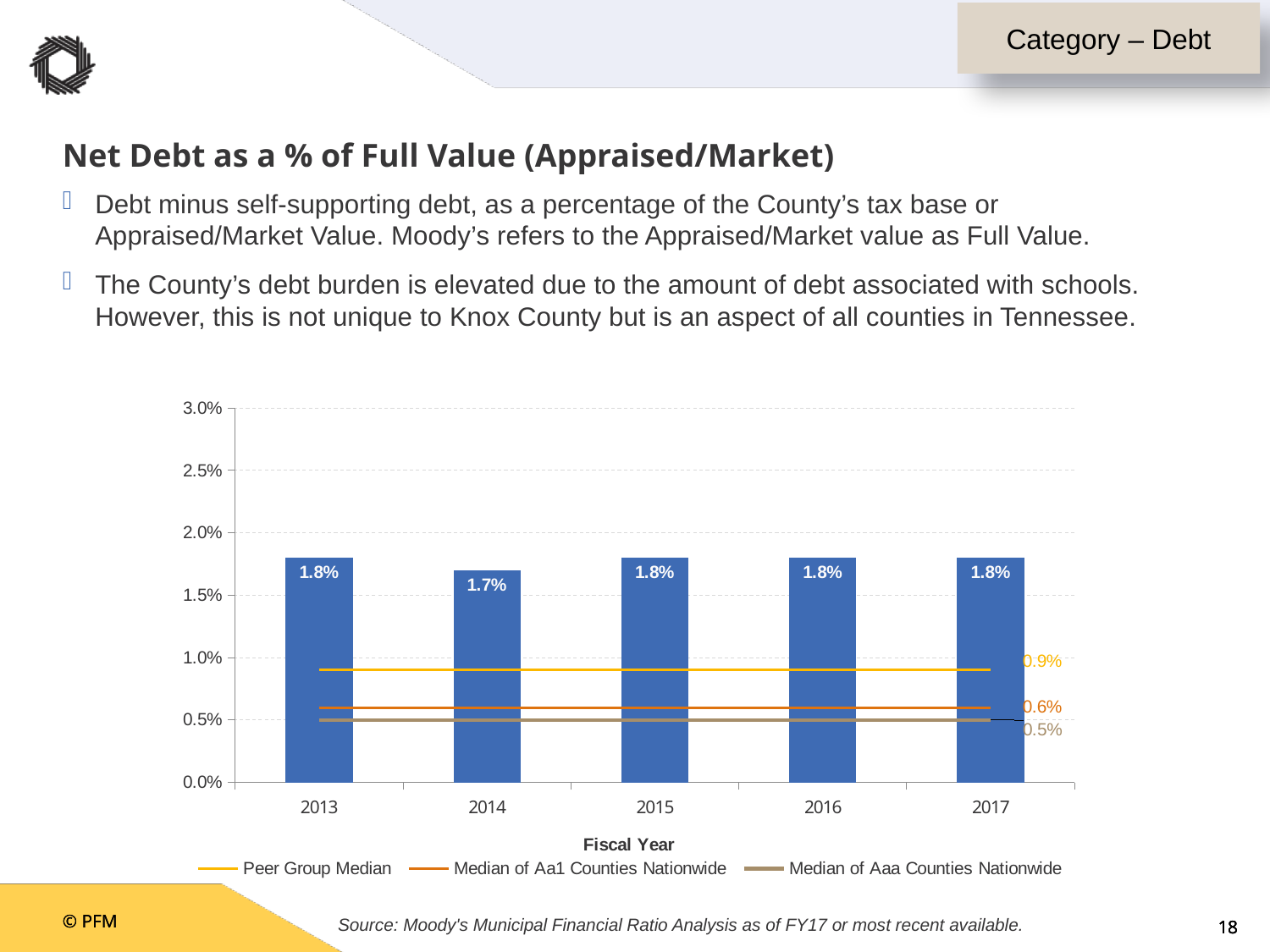
Is the bar value for 2015 larger or smaller than the bar value for 2014? larger How many series does the legend list? 3 What is the value of the bar for fiscal year 2014? 1.7% What is the label of the x axis? Fiscal Year What value is labelled for the Peer Group Median line? 0.9% What is the difference between the bar values for 2013 and 2014? 0.1% Is the bar value for 2016 greater or less than 1.5%? greater Which fiscal year has the lowest bar value? 2014 What value is labelled for the Median of Aaa Counties Nationwide line? 0.5% What is the difference between the Peer Group Median (0.9%) and the Median of Aa1 Counties Nationwide (0.6%)? 0.3% What is the value of the bar for fiscal year 2017? 1.8% How many fiscal years are shown on the x axis? 5